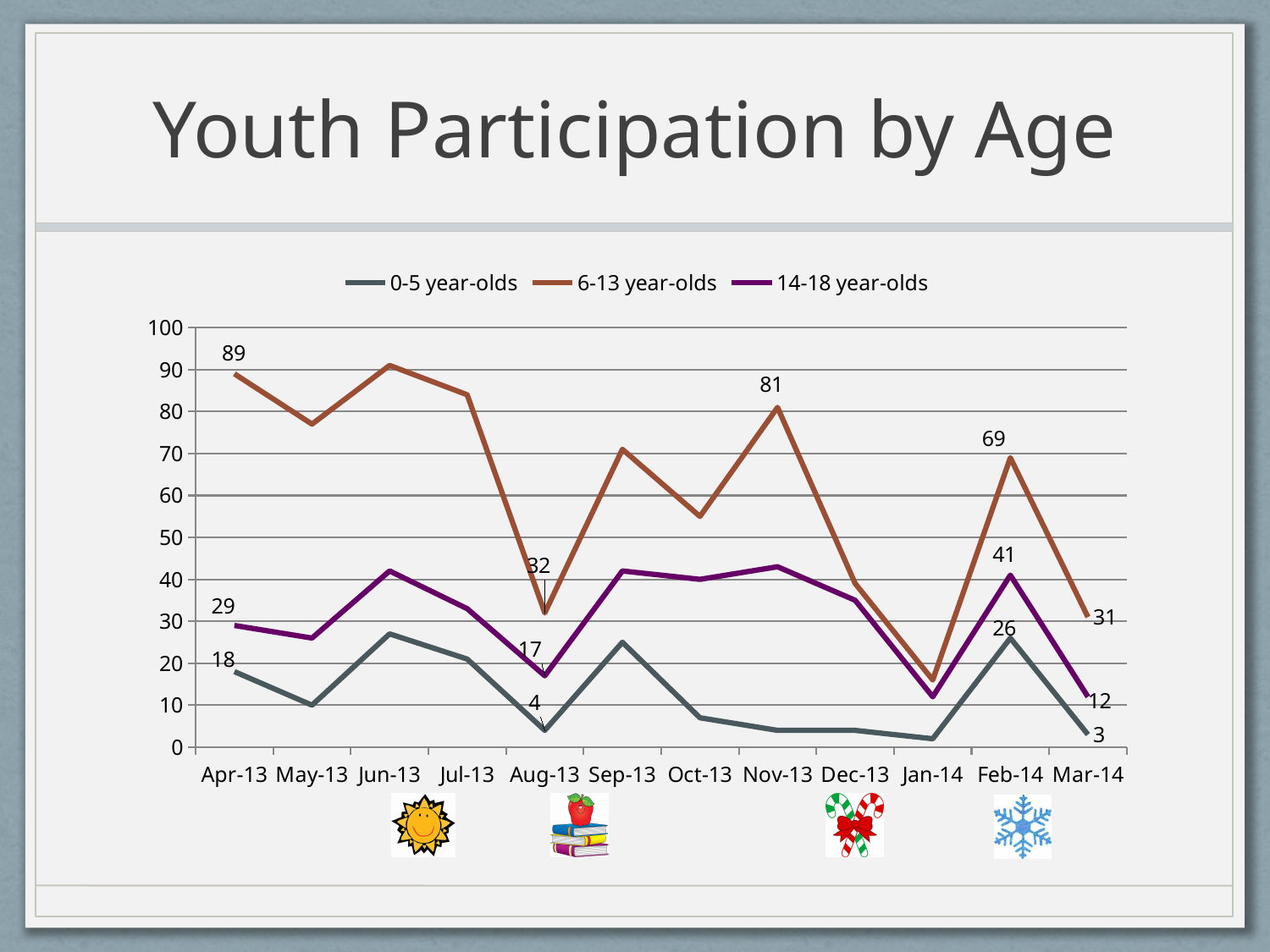
What is the value for 6-13 year-olds in Nov-13? 81 What is the title of the chart? Youth Participation by Age Is the value for 14-18 year-olds in Nov-13 greater or less than 50? less What is the value for 14-18 year-olds in Feb-14? 41 What is the value for 0-5 year-olds in Aug-13? 4 In which month is the value for 6-13 year-olds lowest? Jan-14 What is the difference between the 6-13 year-olds value in Apr-13 and in Mar-14? 58 In Feb-14, which series has the larger value: 6-13 year-olds or 14-18 year-olds? 6-13 year-olds How many months are plotted on the x axis? 12 What is the value for 6-13 year-olds in Apr-13? 89 What kind of chart is shown on the slide? line chart How many series does the legend list? 3